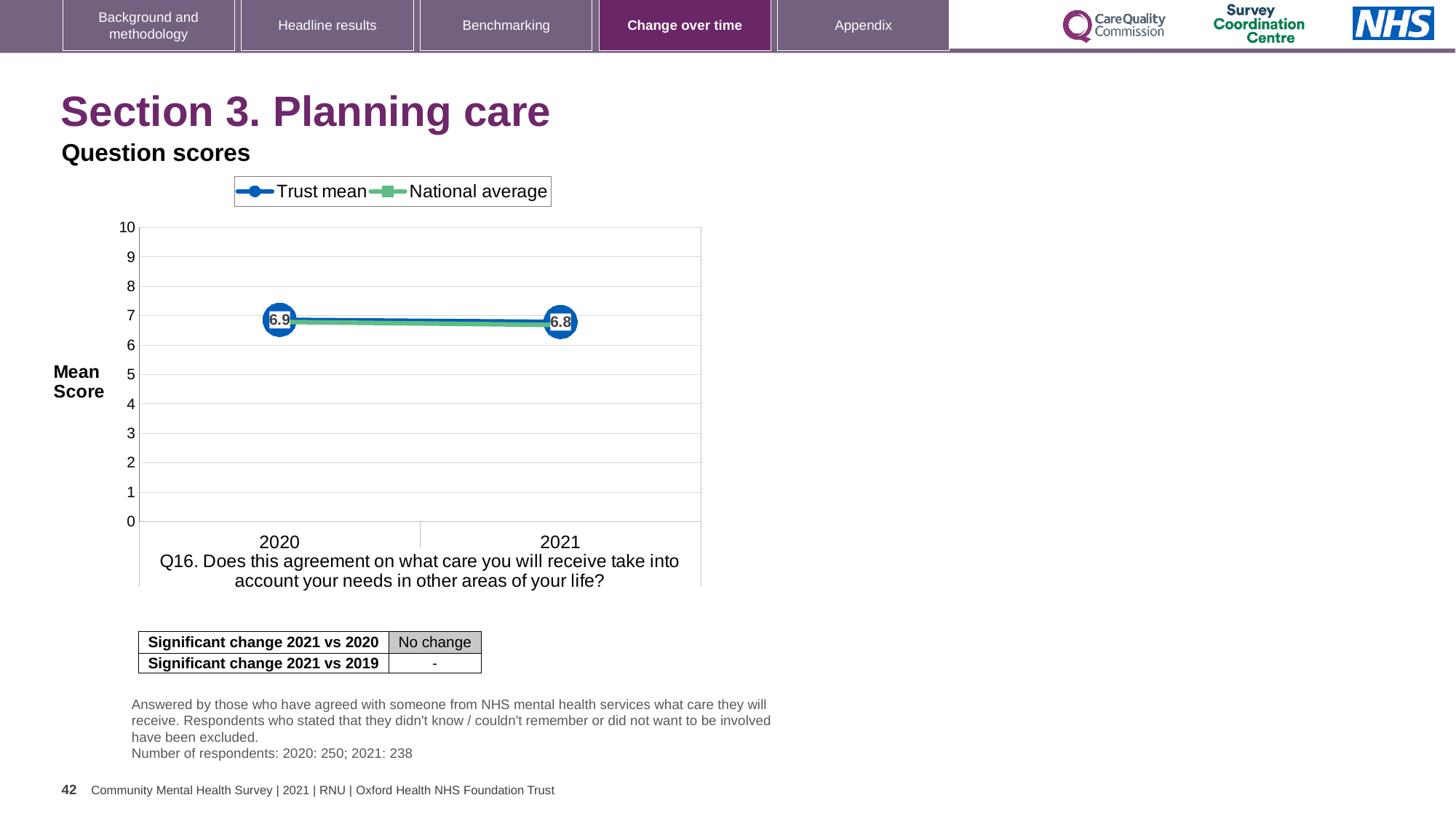
Is the National average for 2021 greater or less than 5? greater What kind of chart is shown? Line chart Which is larger, the Trust mean in 2020 or in 2021? 2020 How many years are plotted on the x axis? 2 Does the Trust mean rise or fall from 2020 to 2021? Fall How many series does the legend list? 2 In which year is the Trust mean highest? 2020 What is the difference between the Trust mean in 2020 and in 2021? 0.1 What is the Trust mean for 2021? 6.8 What is the Trust mean for 2020? 6.9 What is the label on the y axis of the chart? Mean Score In which year is the Trust mean lowest? 2021